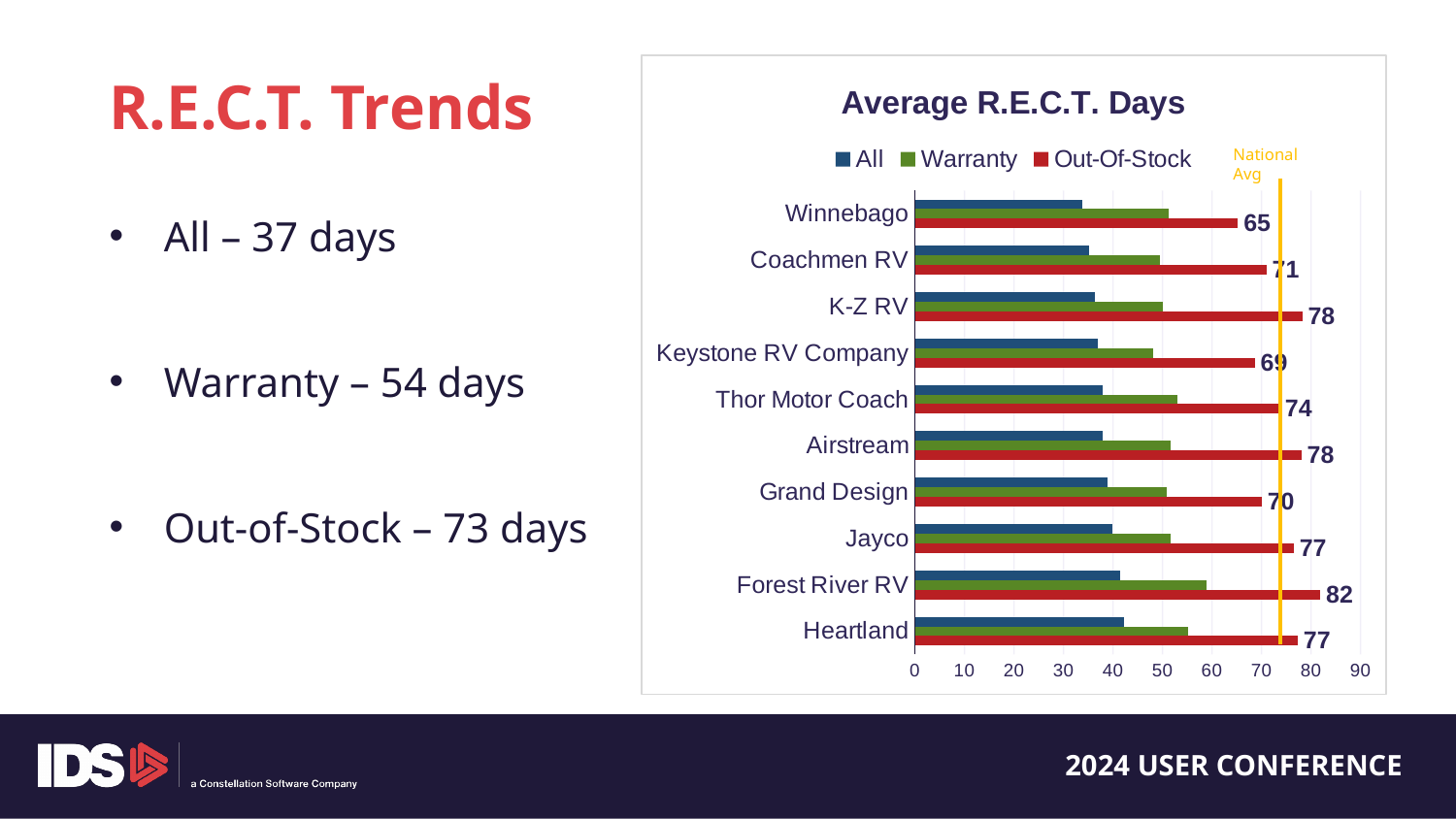
Which has a larger Out-Of-Stock value, Jayco or Grand Design? Jayco How many series does the legend list? 3 What kind of chart is shown on the slide? Bar chart How many categories are shown on the chart? 10 What is the Out-Of-Stock value for Keystone RV Company? 69 What is the difference between the Out-Of-Stock values for Forest River RV and Winnebago? 17 What is the Out-Of-Stock value for Winnebago? 65 Is the All value for Winnebago greater or less than 40? less Is the Warranty value for Forest River RV greater or less than 50? greater Which category has the lowest Out-Of-Stock value? Winnebago Which category has the highest Out-Of-Stock value? Forest River RV What is the Out-Of-Stock value for Forest River RV? 82